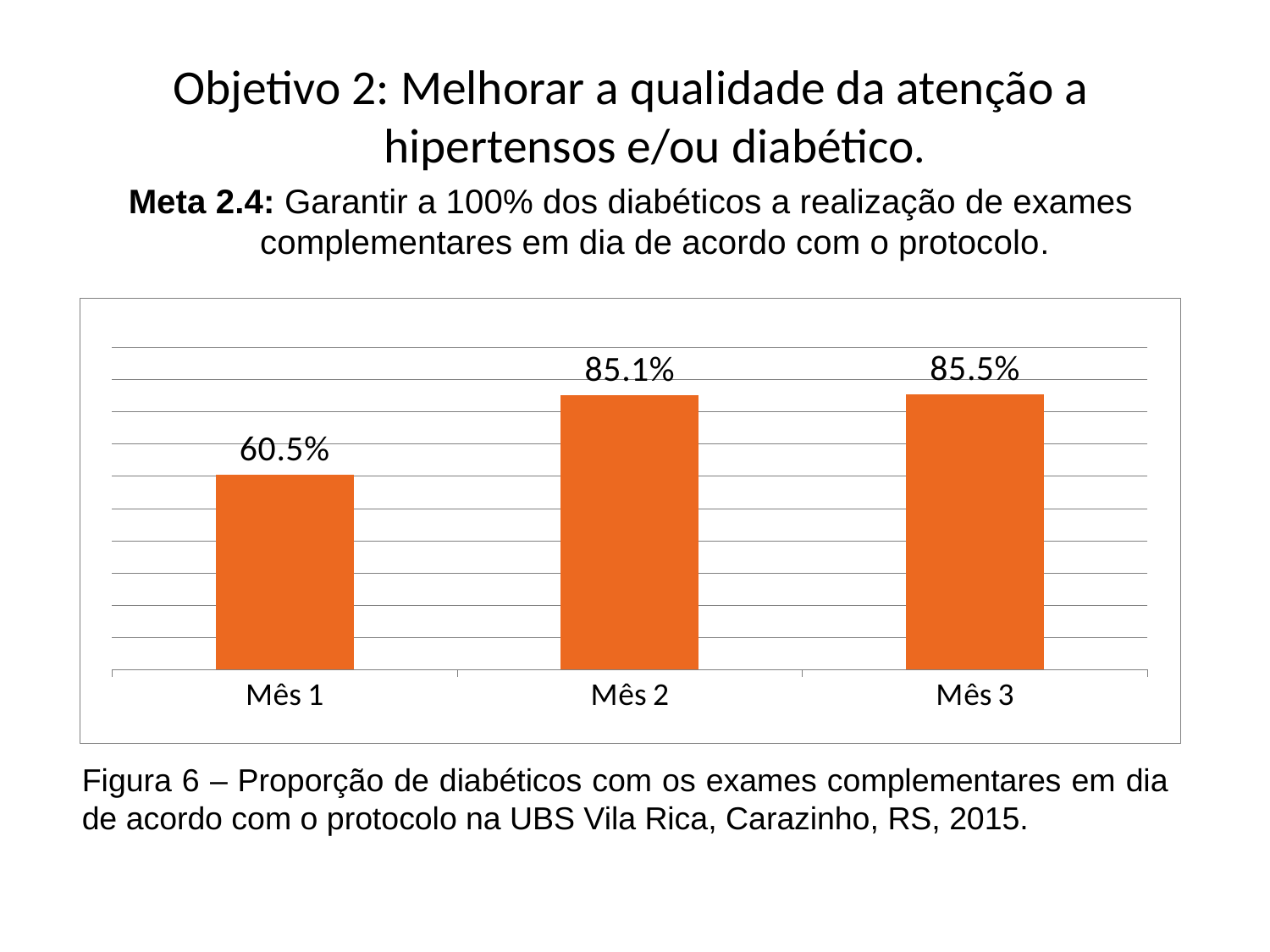
What kind of chart is shown on the slide? Bar chart What is the value for Mês 2? 85.1% What is the value for Mês 3? 85.5% Which is larger, the value for Mês 1 or the value for Mês 2? Mês 2 What is the value for Mês 1? 60.5% What colour are the bars in the chart? Orange How many months are shown on the x axis? 3 Which month has the highest value? Mês 3 Do the values rise or fall from Mês 1 to Mês 3? Rise What is the difference between the values for Mês 3 and Mês 2? 0.4% What is the difference between the values for Mês 2 and Mês 1? 24.6% Which month has the lowest value? Mês 1